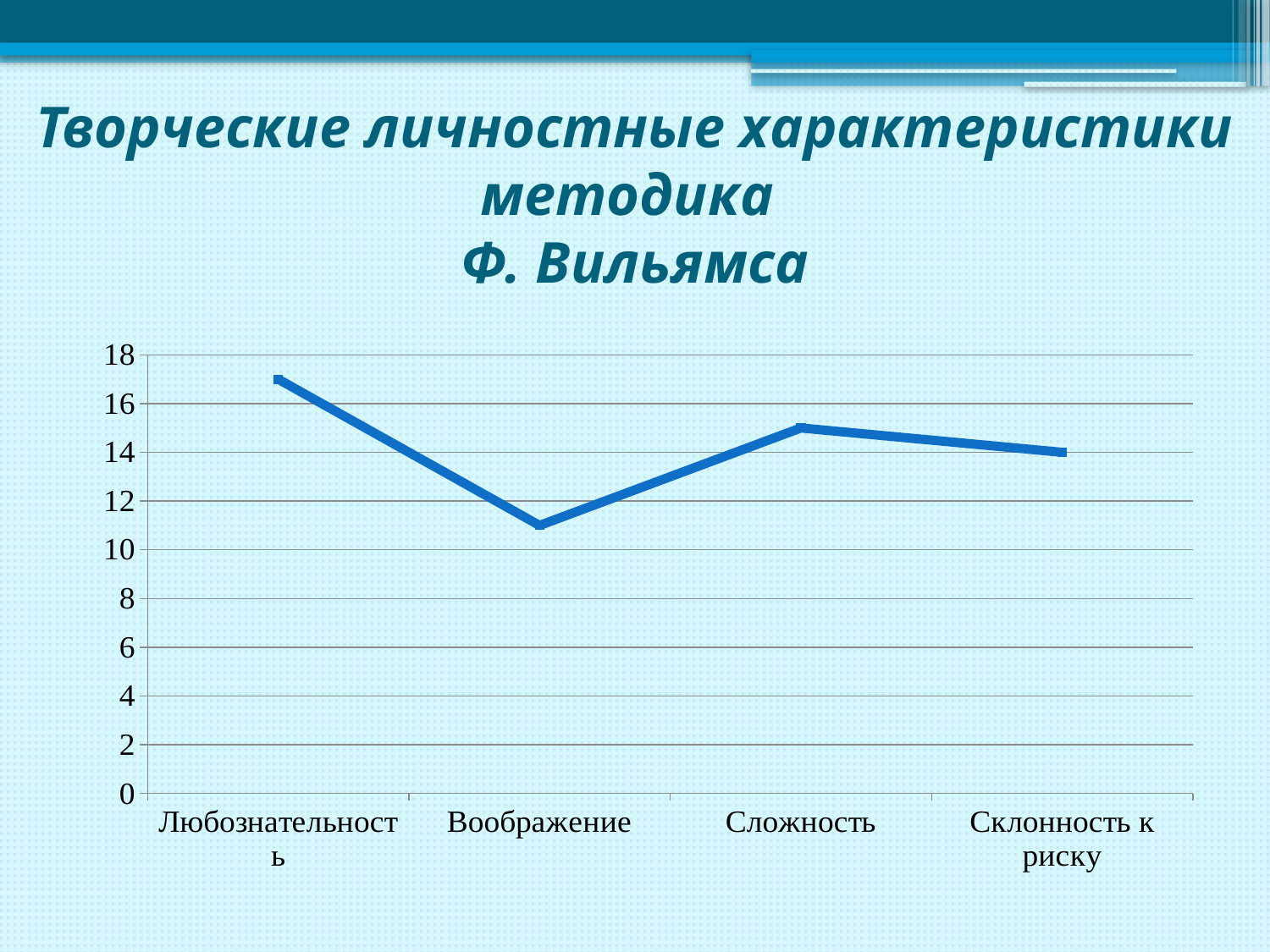
What kind of chart is shown on the slide? line chart Is the value for Воображение greater or less than 12? less Does the line rise or fall from Любознательность to Воображение? fall Is the value for Сложность greater or less than 14? greater Which is larger, the value for Любознательность or the value for Воображение? Любознательность Is the value for Любознательность greater or less than 16? greater Which category has the lowest value in the chart? Воображение What is the title of the slide containing the chart? Творческие личностные характеристики методика Ф. Вильямса How many categories are plotted on the x axis of the chart? 4 Which is larger, the value for Сложность or the value for Воображение? Сложность Which category has the highest value in the chart? Любознательность